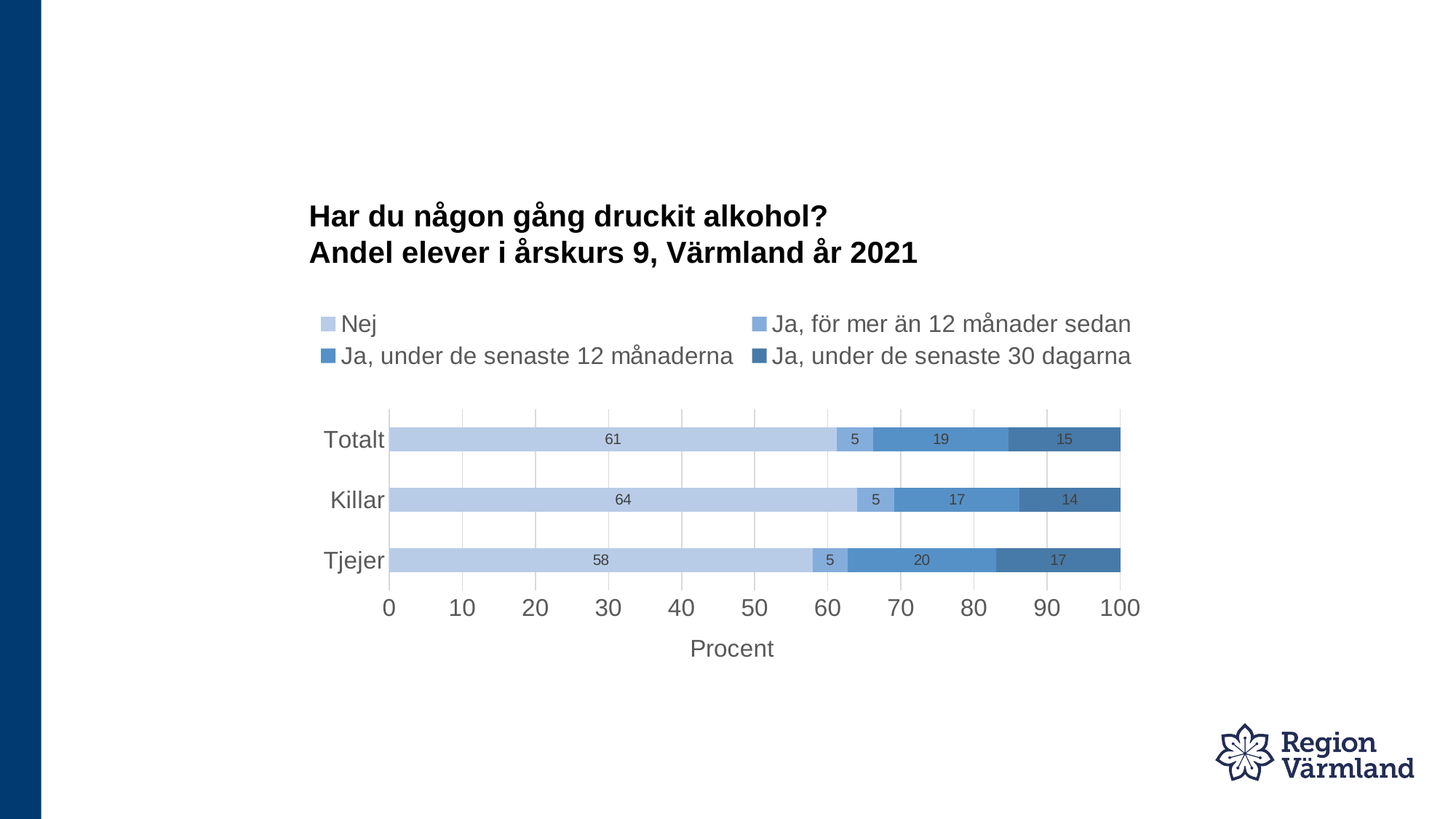
What kind of chart is shown on the slide? Stacked bar chart Which category has the lowest value for "Ja, under de senaste 30 dagarna"? Killar What is the label of the x axis? Procent How many categories are shown on the y axis? 3 What is the difference between the "Nej" values for Killar and Tjejer? 6 What is the value of "Ja, under de senaste 12 månaderna" for Killar? 17 What is the value of "Ja, under de senaste 30 dagarna" for Tjejer? 17 What is the total of the stacked bar for Totalt? 100 Is the "Ja, under de senaste 12 månaderna" value larger for Tjejer or for Killar? Tjejer How many series does the legend list? 4 What is the value of "Nej" for Totalt? 61 Which category has the highest value for "Nej"? Killar